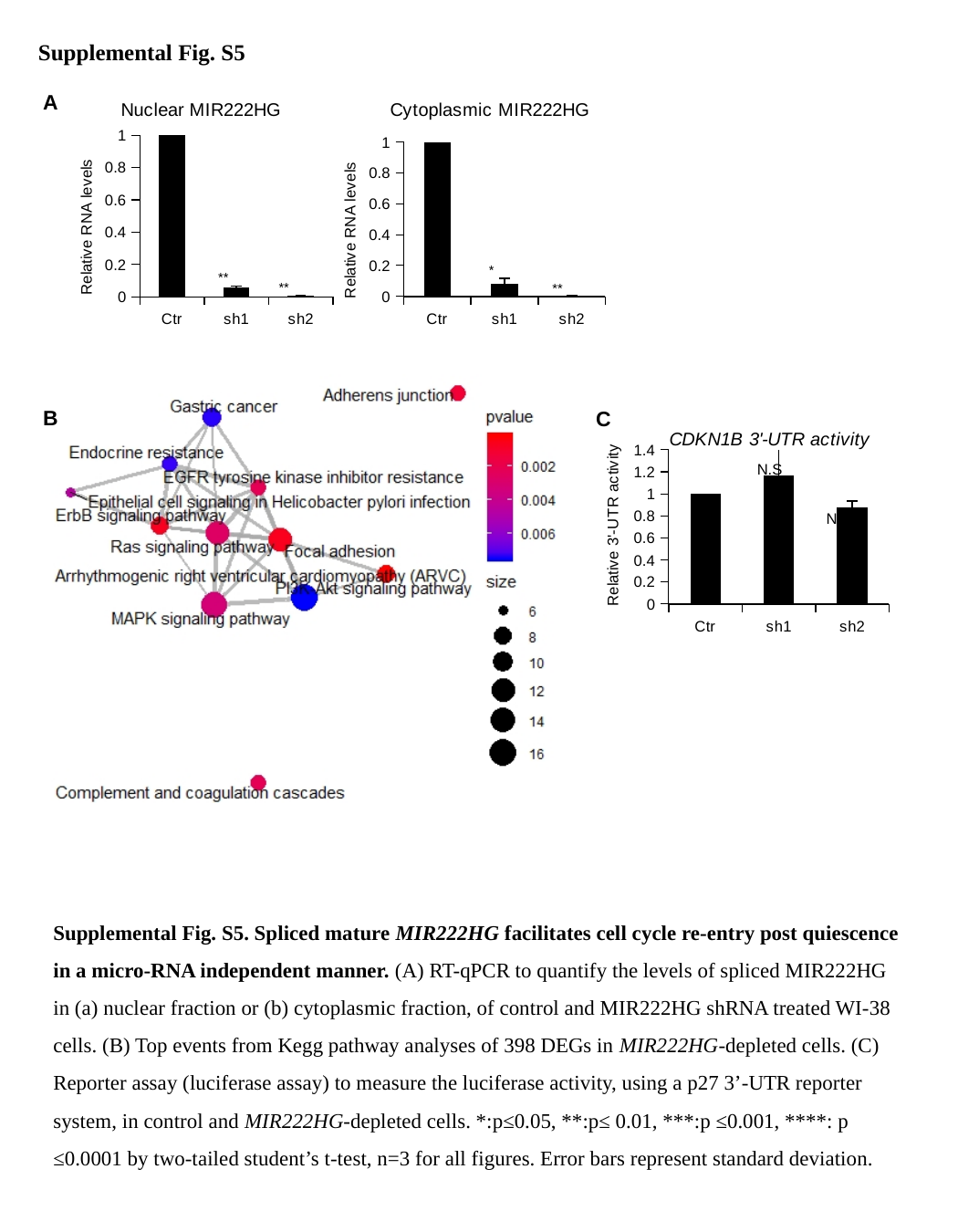
What is the y-axis title of the Nuclear MIR222HG chart? Relative RNA levels In the Cytoplasmic MIR222HG chart, which category has the lowest relative RNA level? sh2 How many categories are shown on the x axis of the Nuclear MIR222HG chart? 3 In the Nuclear MIR222HG chart, is the value for sh1 greater or less than 0.2? less In the CDKN1B 3'-UTR activity chart, is the value for sh2 greater or less than 1? less In the Cytoplasmic MIR222HG chart, what is the relative RNA level for Ctr? 1 In the Nuclear MIR222HG chart, which category has the highest relative RNA level? Ctr In the CDKN1B 3'-UTR activity chart, which category has the highest relative 3'-UTR activity? sh1 In the Nuclear MIR222HG chart, what is the relative RNA level for Ctr? 1 What kind of chart is the Cytoplasmic MIR222HG chart? bar chart In the Cytoplasmic MIR222HG chart, is the value for sh1 greater or less than 0.4? less In the CDKN1B 3'-UTR activity chart, which is larger, the value for Ctr or the value for sh2? Ctr